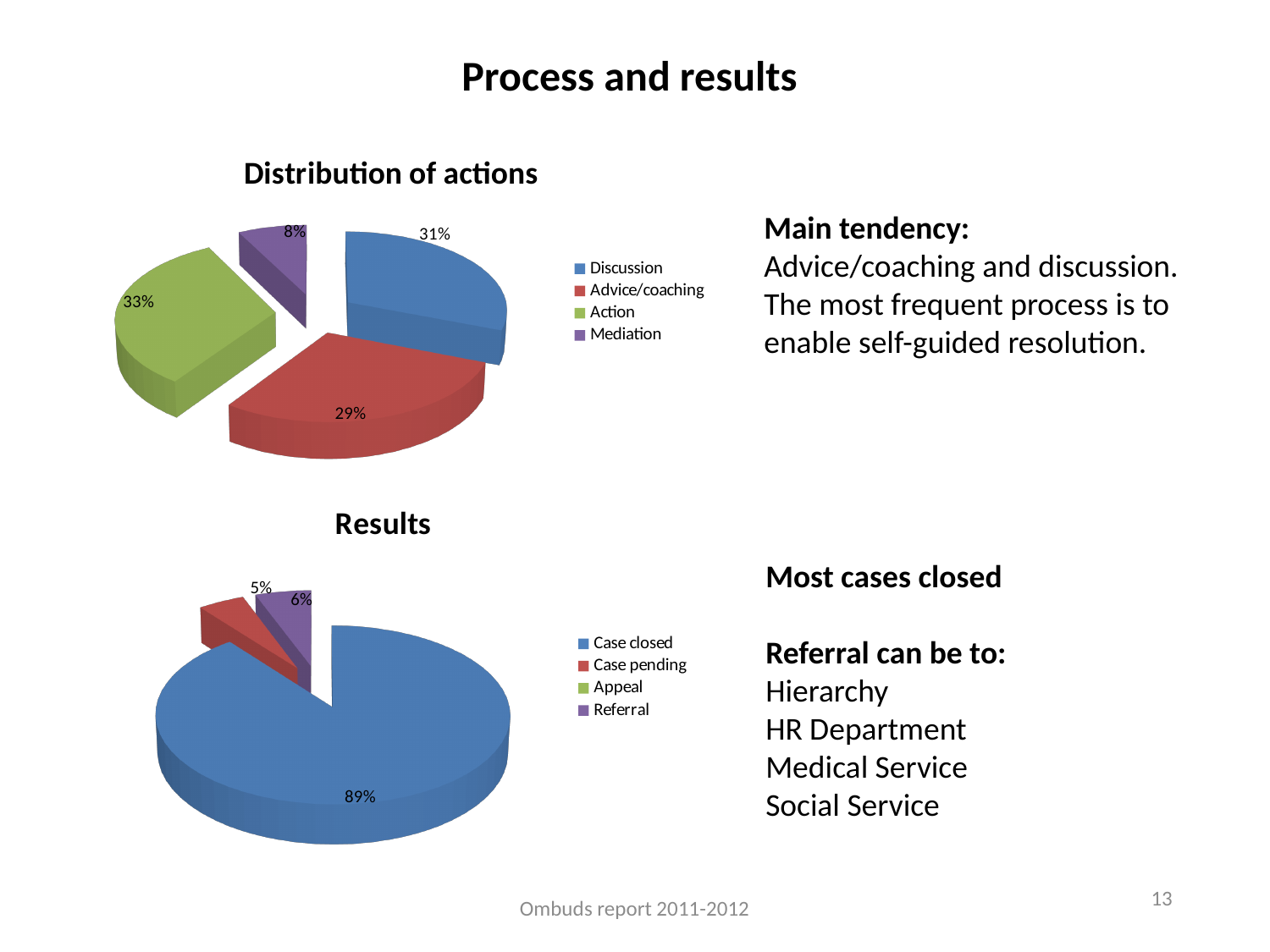
In the Distribution of actions chart, which category has the largest share? Action In the Distribution of actions chart, what share is Mediation? 8% In the Results chart, what share is Case closed? 89% In the Results chart, what colour is the Case closed slice? Blue In the Distribution of actions chart, which category has the smallest share? Mediation In the Results chart, what share is Referral? 6% In the Results chart, which is larger, Case pending or Referral? Referral In the Distribution of actions chart, how many categories does the legend list? 4 In the Distribution of actions chart, what share is Advice/coaching? 29% In the Distribution of actions chart, what is the difference between the Action and Mediation shares? 25% In the Distribution of actions chart, what share is Discussion? 31% What type of chart is the Results chart? Pie chart